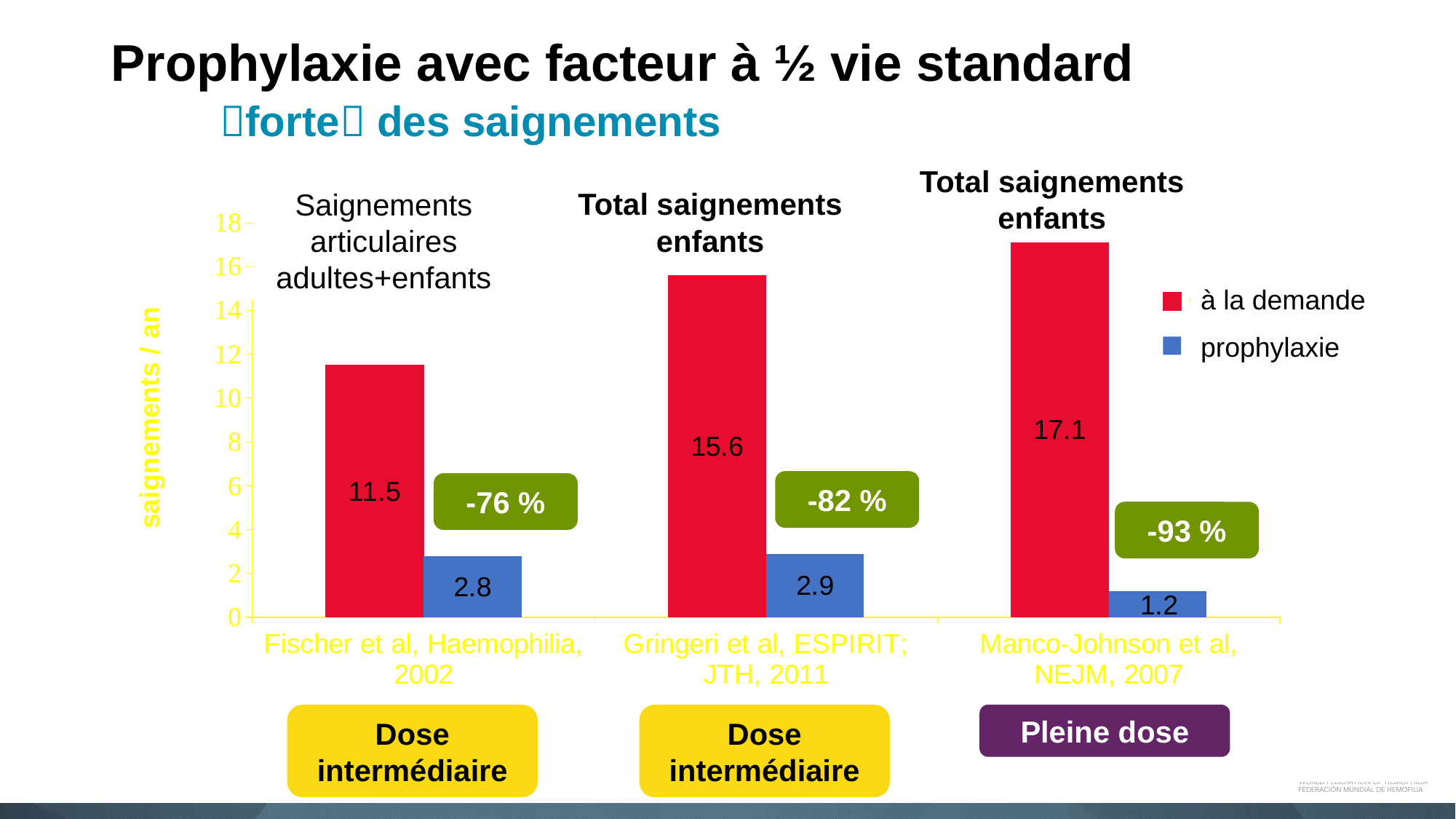
What is the 'prophylaxie' value for Gringeri et al, ESPIRIT; JTH, 2011? 2.9 What is the y-axis label of the chart? saignements / an How many studies (categories) are shown on the x axis? 3 What kind of chart is shown on the slide? Bar chart What is the 'prophylaxie' value for Manco-Johnson et al, NEJM, 2007? 1.2 How many series does the legend list? 2 Which study has the highest 'à la demande' value? Manco-Johnson et al, NEJM, 2007 What is the 'à la demande' value for Fischer et al, Haemophilia, 2002? 11.5 Which study has the lowest 'prophylaxie' value? Manco-Johnson et al, NEJM, 2007 Which is larger: the 'à la demande' value for Gringeri et al, ESPIRIT; JTH, 2011 or for Fischer et al, Haemophilia, 2002? Gringeri et al, ESPIRIT; JTH, 2011 What is the difference between the 'à la demande' and 'prophylaxie' values for Fischer et al, Haemophilia, 2002? 8.7 What is the difference between the 'à la demande' values for Manco-Johnson et al, NEJM, 2007 and Gringeri et al, ESPIRIT; JTH, 2011? 1.5